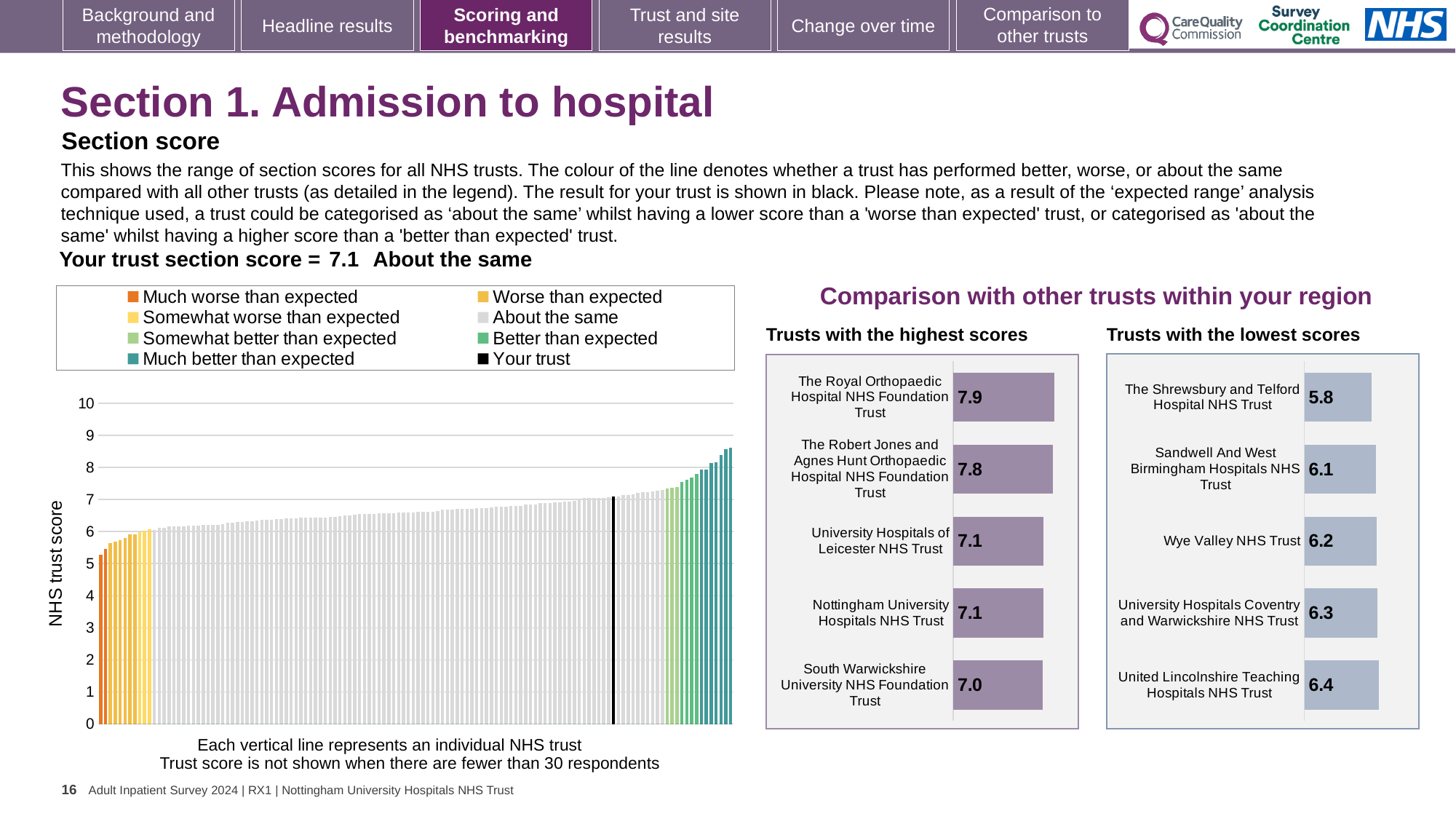
In the 'Trusts with the highest scores' chart, what is the difference between the scores of The Royal Orthopaedic Hospital NHS Foundation Trust and South Warwickshire University NHS Foundation Trust? 0.9 In the large 'NHS trust score' chart on the left, is the value of the leftmost bar greater or less than 6? less In the 'Trusts with the highest scores' chart, what is the score for The Royal Orthopaedic Hospital NHS Foundation Trust? 7.9 In the 'Trusts with the lowest scores' chart, what is the difference between the scores of University Hospitals Coventry and Warwickshire NHS Trust and The Shrewsbury and Telford Hospital NHS Trust? 0.5 In the 'Trusts with the lowest scores' chart, which trust has the lowest score? The Shrewsbury and Telford Hospital NHS Trust What kind of chart is the large 'NHS trust score' chart on the left of the slide? Bar chart In the 'Trusts with the lowest scores' chart, which has the larger score: Sandwell And West Birmingham Hospitals NHS Trust or United Lincolnshire Teaching Hospitals NHS Trust? United Lincolnshire Teaching Hospitals NHS Trust In the 'Trusts with the highest scores' chart, which trust has the highest score? The Royal Orthopaedic Hospital NHS Foundation Trust How many entries does the legend above the large 'NHS trust score' chart list? 8 How many trusts are shown in the 'Trusts with the highest scores' chart? 5 In the 'Trusts with the lowest scores' chart, what is the score for Wye Valley NHS Trust? 6.2 In the large 'NHS trust score' chart on the left, do the values rise or fall from left to right? Rise